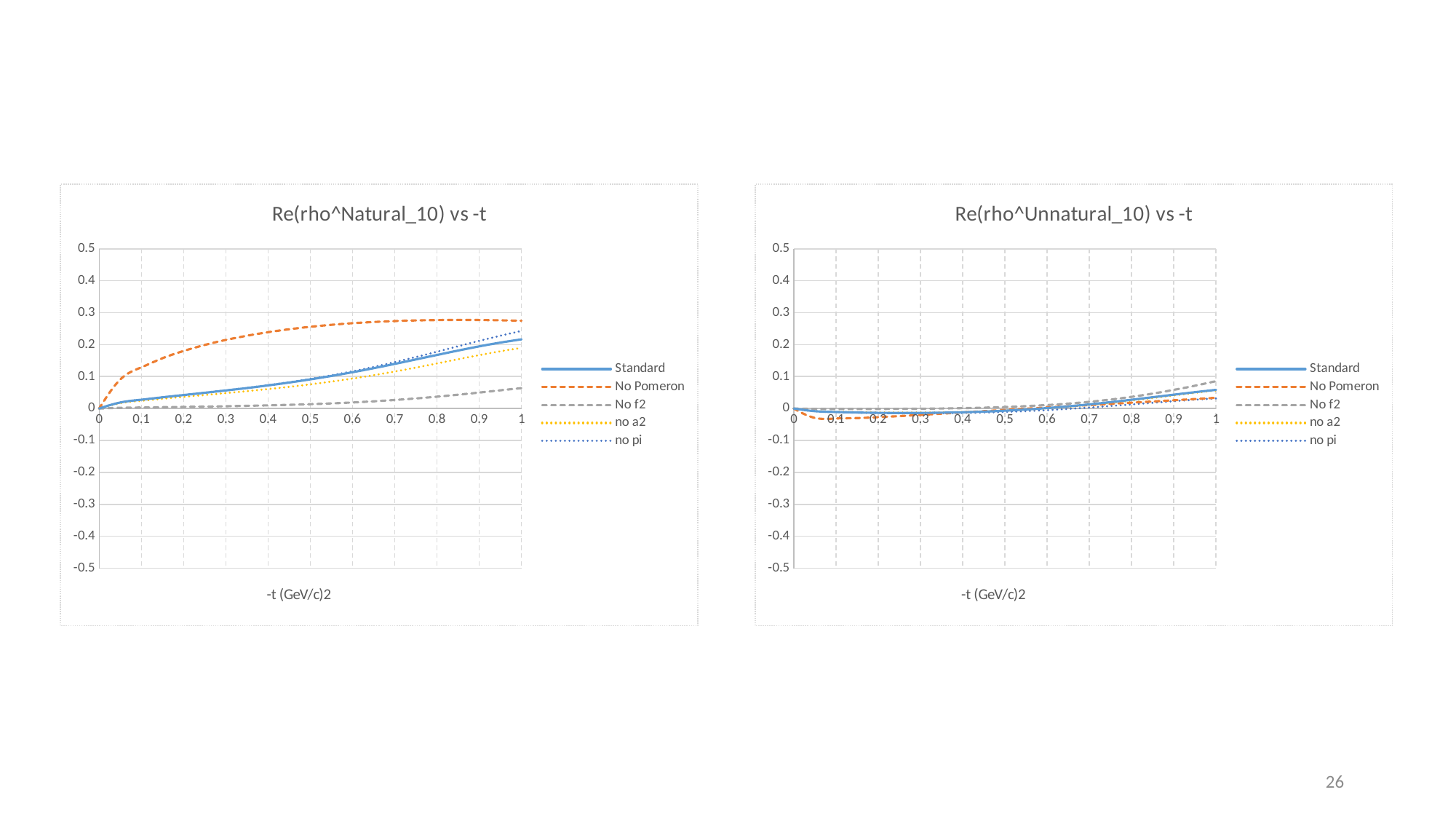
What kind of chart is the left chart, titled "Re(rho^Natural_10) vs -t"? line chart In the left chart, "Re(rho^Natural_10) vs -t", does the Standard series rise or fall as -t increases from 0 to 1? rise In the right chart, "Re(rho^Unnatural_10) vs -t", which series has the highest value at -t = 1? No f2 What is the title of the right chart? Re(rho^Unnatural_10) vs -t How many series does the legend of the left chart, "Re(rho^Natural_10) vs -t", list? 5 In the left chart, "Re(rho^Natural_10) vs -t", which series has the lowest value at -t = 1? No f2 In the right chart, "Re(rho^Unnatural_10) vs -t", is the value of the No f2 series at -t = 1 greater or less than 0.1? less What is the x-axis label of the left chart, "Re(rho^Natural_10) vs -t"? -t (GeV/c)2 In the left chart, "Re(rho^Natural_10) vs -t", is the value of the No Pomeron series at -t = 1 greater or less than 0.2? greater In the left chart, "Re(rho^Natural_10) vs -t", which is larger at -t = 0.5: the No Pomeron series or the Standard series? No Pomeron In the left chart, "Re(rho^Natural_10) vs -t", is the value of the No f2 series at -t = 1 greater or less than 0.1? less In the left chart, "Re(rho^Natural_10) vs -t", which series has the highest value at -t = 0.5? No Pomeron